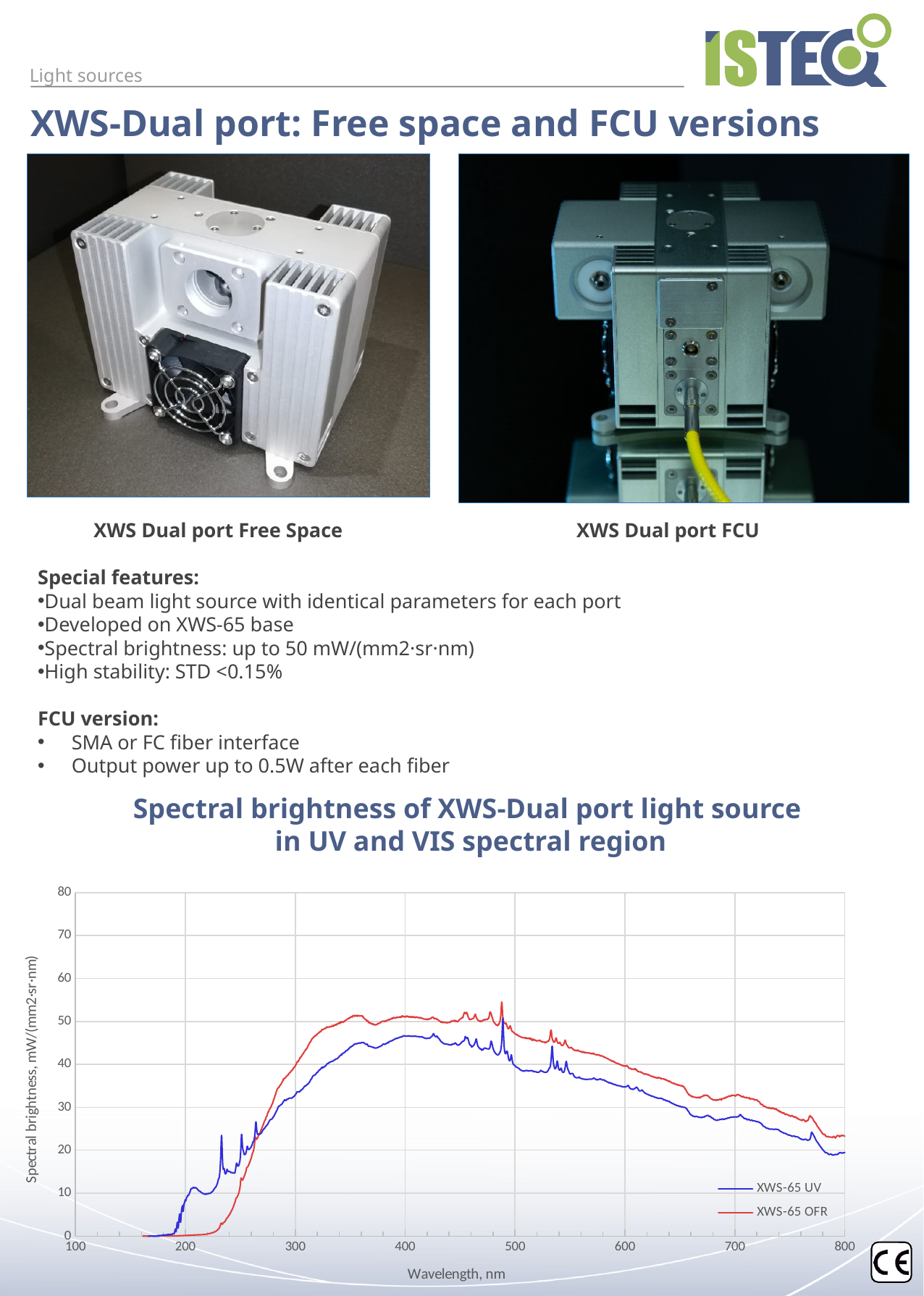
Is the value of XWS-65 OFR at 400 nm greater or less than 40? greater Between 600 nm and 800 nm, does the XWS-65 OFR curve rise or fall? fall What kind of chart is shown at the bottom of the slide? line chart At 600 nm, which series has the higher spectral brightness, XWS-65 UV or XWS-65 OFR? XWS-65 OFR At 250 nm, which series has the higher spectral brightness, XWS-65 UV or XWS-65 OFR? XWS-65 UV What is the label of the x axis of the spectral brightness chart? Wavelength, nm Is the value of XWS-65 UV at 800 nm greater or less than 30? less What are the two series named in the legend of the spectral brightness chart? XWS-65 UV and XWS-65 OFR How many series does the legend of the spectral brightness chart list? 2 Between 200 nm and 350 nm, does the XWS-65 UV curve rise or fall? rise Is the value of XWS-65 UV at 300 nm greater or less than 40? less